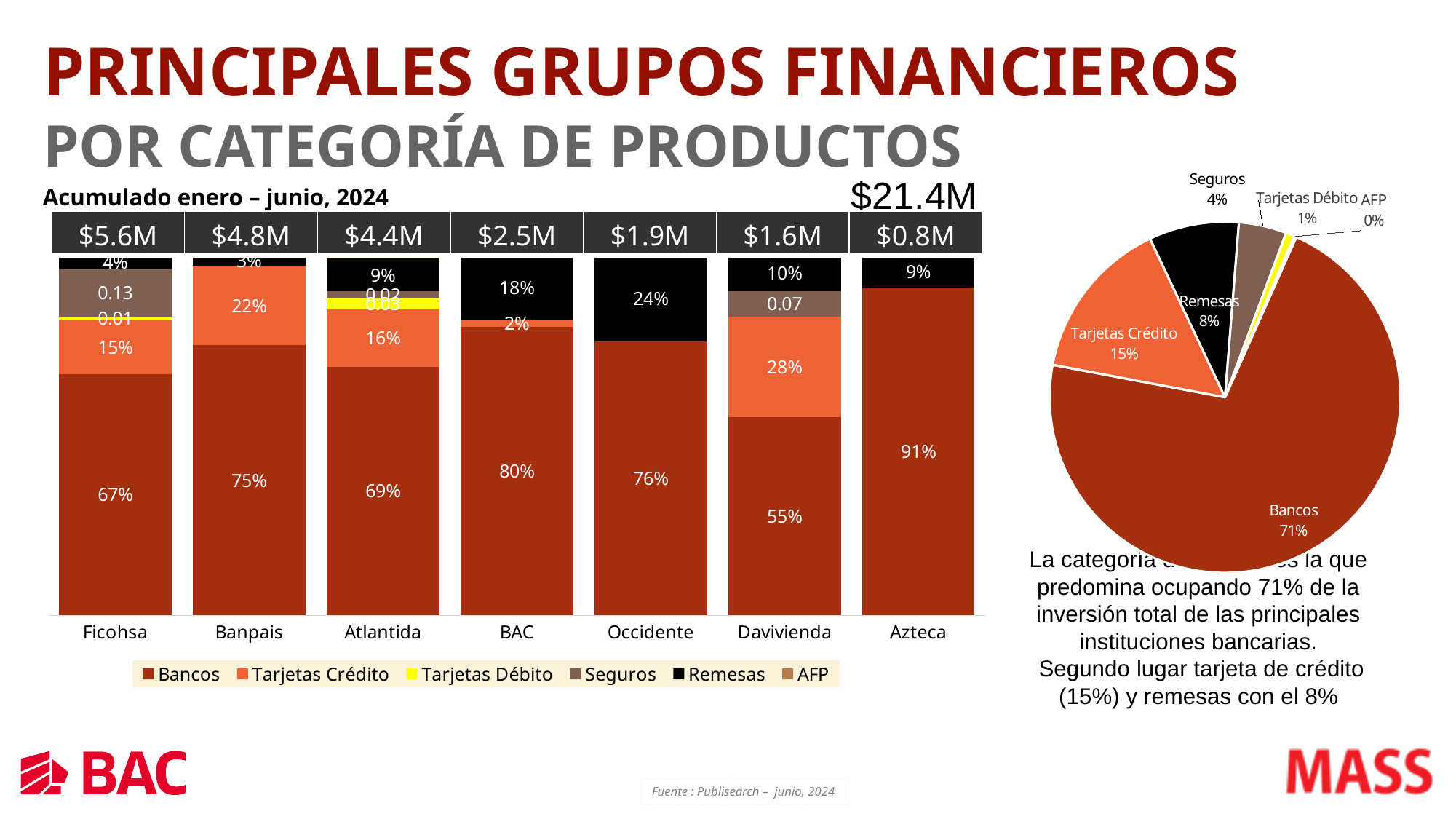
In the stacked bar chart, what is the difference between the Bancos share of BAC and that of Ficohsa? 13% What total amount is shown above the Banpais bar in the stacked bar chart? $4.8M In the stacked bar chart, which financial group has the lowest Bancos share? Davivienda What kind of chart is shown on the right side of the slide? Pie chart In the pie chart, what share does Tarjetas Crédito have? 15% In the stacked bar chart, what is the Bancos share for Azteca? 91% In the stacked bar chart, what is the Remesas share for Occidente? 24% In the stacked bar chart, which is larger: the Remesas share for BAC or for Davivienda? BAC How many financial groups are shown in the stacked bar chart? 7 In the stacked bar chart, what is the Tarjetas Crédito share for Davivienda? 28% In the stacked bar chart, which financial group has the highest Bancos share? Azteca How many series does the legend of the stacked bar chart list? 6